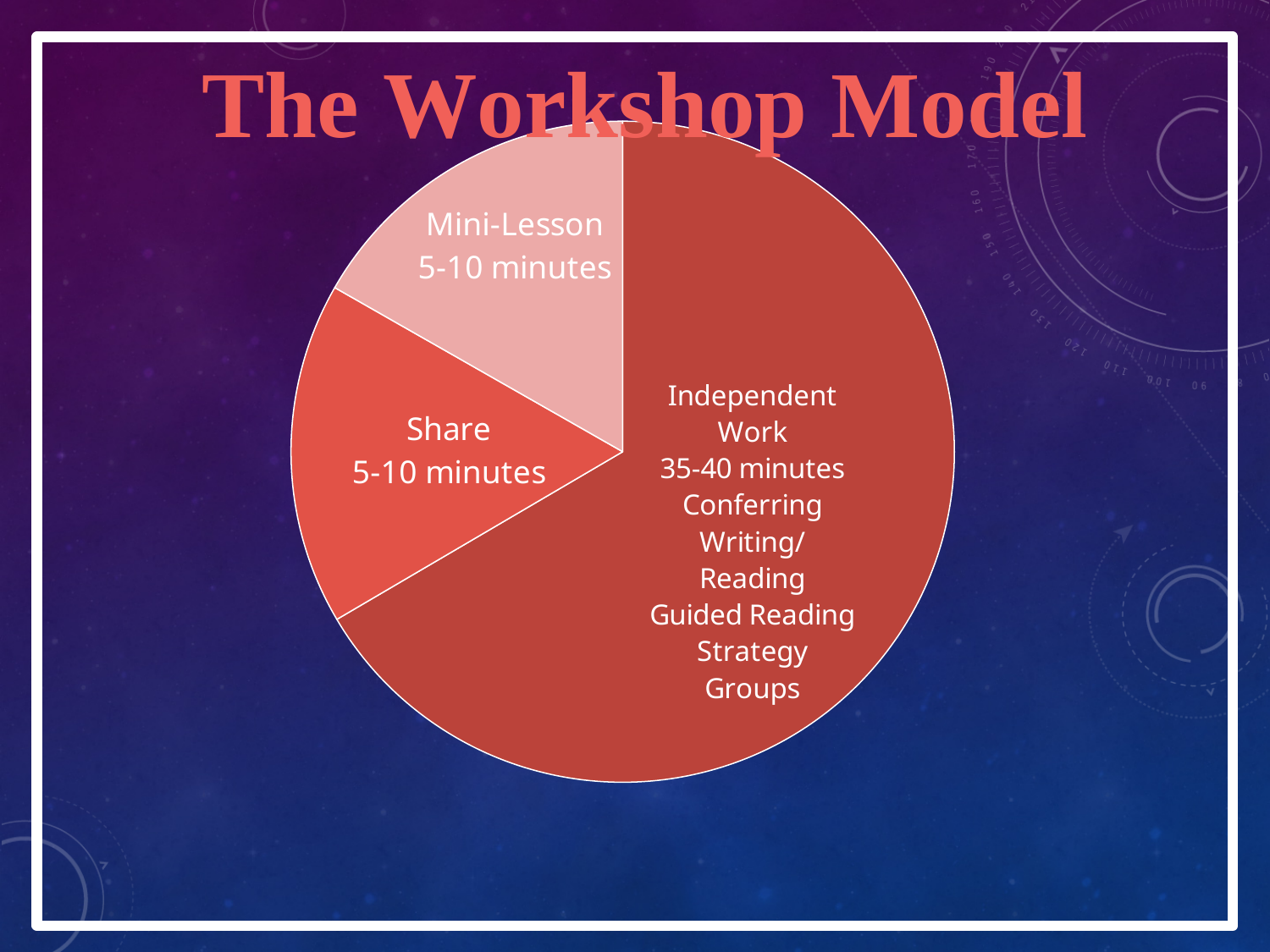
Which slice of the pie chart is coloured light pink? Mini-Lesson Which slice is larger, Independent Work or Share? Independent Work How many minutes are allotted to Independent Work according to the chart? 35-40 minutes Which slice is larger, Mini-Lesson or Independent Work? Independent Work What kind of chart is shown on the slide? Pie chart How many minutes are allotted to the Mini-Lesson according to the chart? 5-10 minutes How many slices does the pie chart have? 3 Which slice of the pie chart is the largest? Independent Work What is the title of the slide containing the pie chart? The Workshop Model How many minutes are allotted to Share according to the chart? 5-10 minutes